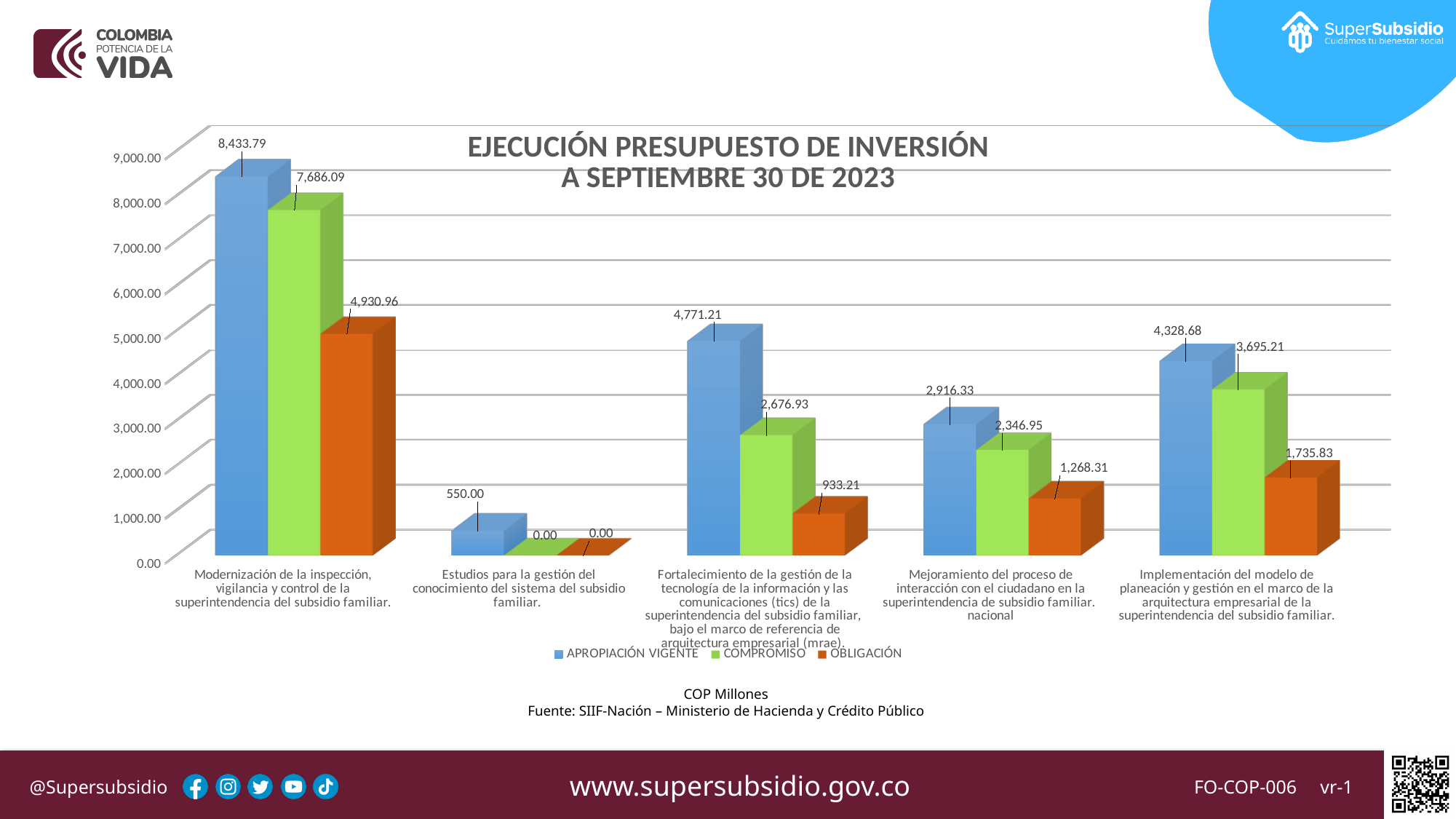
What is the title of the chart? EJECUCIÓN PRESUPUESTO DE INVERSIÓN A SEPTIEMBRE 30 DE 2023 Which category has the lowest APROPIACIÓN VIGENTE value? Estudios para la gestión del conocimiento del sistema del subsidio familiar. What is the APROPIACIÓN VIGENTE value for 'Modernización de la inspección, vigilancia y control de la superintendencia del subsidio familiar'? 8,433.79 What is the OBLIGACIÓN value for 'Fortalecimiento de la gestión de la tecnología de la información y las comunicaciones (tics)...'? 933.21 What type of chart is shown on the slide? bar chart Which is larger: the COMPROMISO value for 'Mejoramiento del proceso de interacción con el ciudadano...' or the OBLIGACIÓN value for 'Implementación del modelo de planeación y gestión...'? COMPROMISO for Mejoramiento del proceso de interacción con el ciudadano (2,346.95) What is the difference between APROPIACIÓN VIGENTE and COMPROMISO for 'Fortalecimiento de la gestión de la tecnología de la información...'? 2,094.28 Which category has the highest OBLIGACIÓN value? Modernización de la inspección, vigilancia y control de la superintendencia del subsidio familiar. Which colour represents the OBLIGACIÓN series? orange How many categories are shown on the x axis? 5 What is the COMPROMISO value for 'Implementación del modelo de planeación y gestión en el marco de la arquitectura empresarial...'? 3,695.21 How many series does the legend list? 3